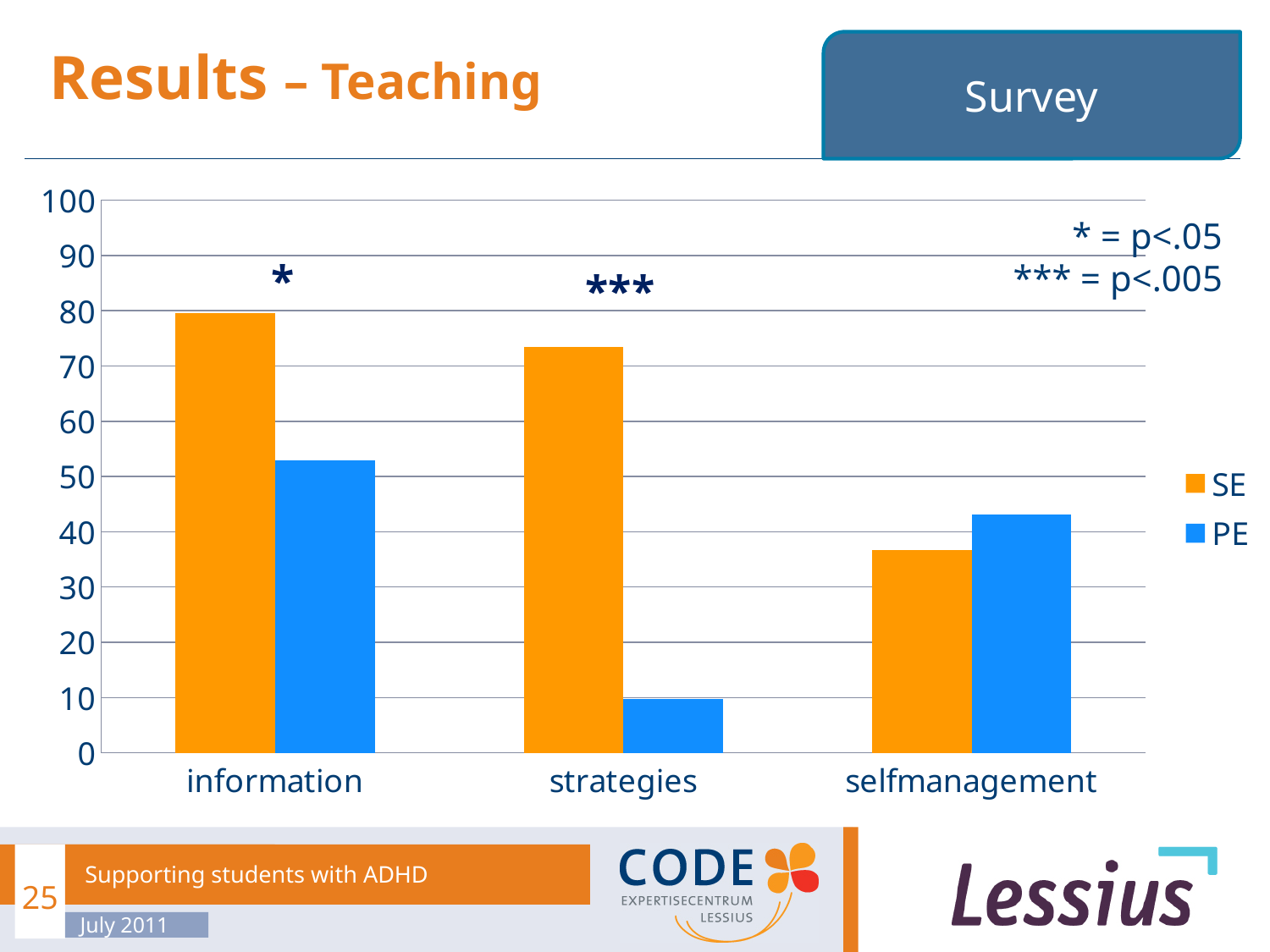
Which category has the lowest PE value? strategies What are the two series names listed in the chart's legend? SE and PE Which category has the lowest SE value? selfmanagement Which category has the highest SE value? information Is the SE value for information greater or less than 70? greater Is the PE value for strategies greater or less than 20? less What kind of chart is shown on the slide? bar chart For the strategies category, which series has the larger value, SE or PE? SE For the selfmanagement category, which series has the larger value, SE or PE? PE How many series does the chart's legend list? 2 Is the PE value for information greater or less than 60? less How many categories are shown on the x axis of the chart? 3